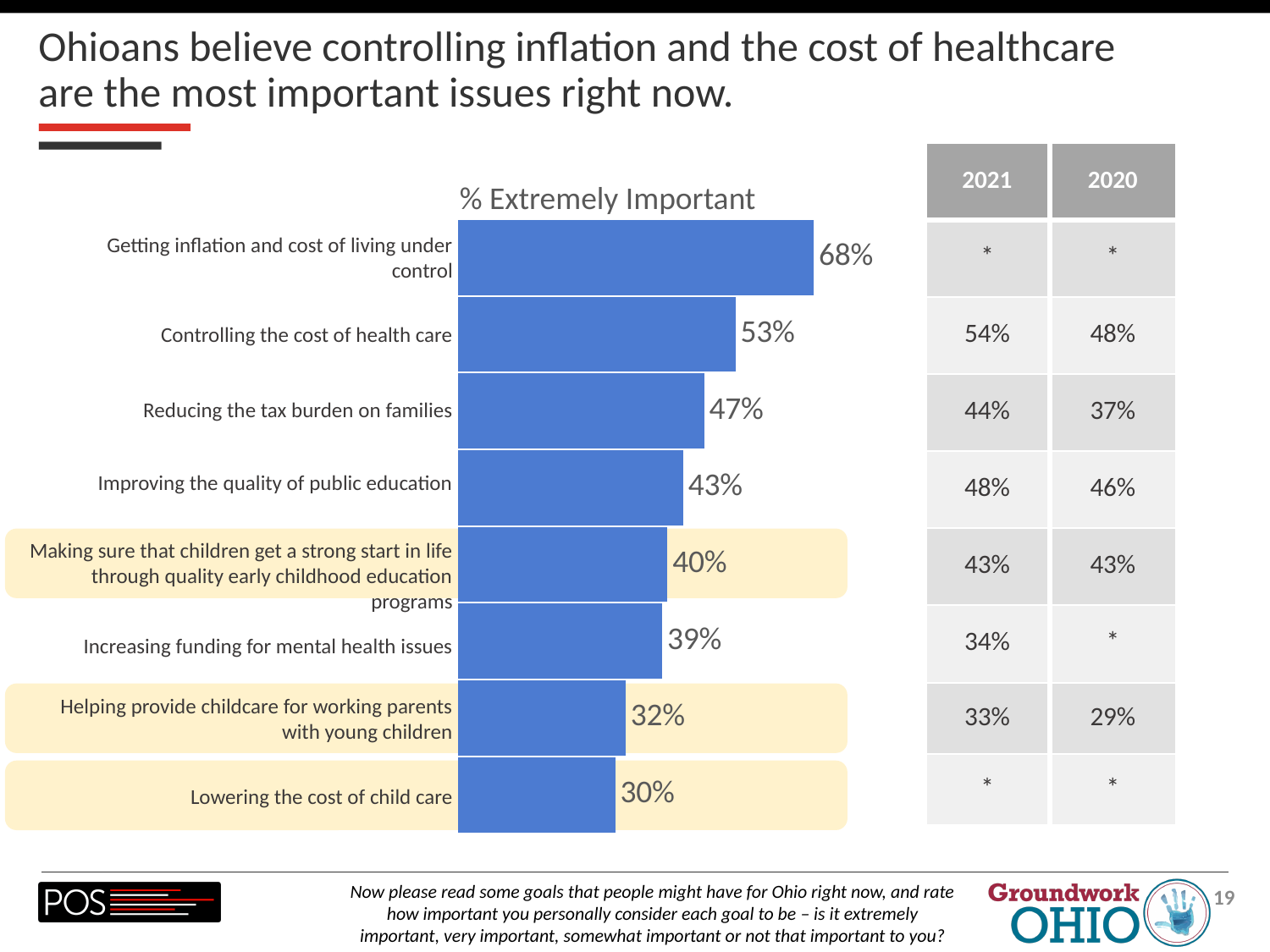
What is the value for lowering the cost of child care? 30% How many goals are plotted in the chart? 8 What kind of chart is shown on the slide? Bar chart What is the value for reducing the tax burden on families? 47% Which goal has the lowest share rating it extremely important? Lowering the cost of child care Which goal has the highest share rating it extremely important? Getting inflation and cost of living under control What is the difference between the values for getting inflation under control and controlling the cost of health care? 15 percentage points What is the title of the chart? % Extremely Important What percentage of Ohioans rate getting inflation and cost of living under control as extremely important? 68% What is the difference between the values for helping provide childcare for working parents with young children and lowering the cost of child care? 2 percentage points What is the value for controlling the cost of health care? 53% Which is larger: the value for improving the quality of public education or the value for increasing funding for mental health issues? Improving the quality of public education